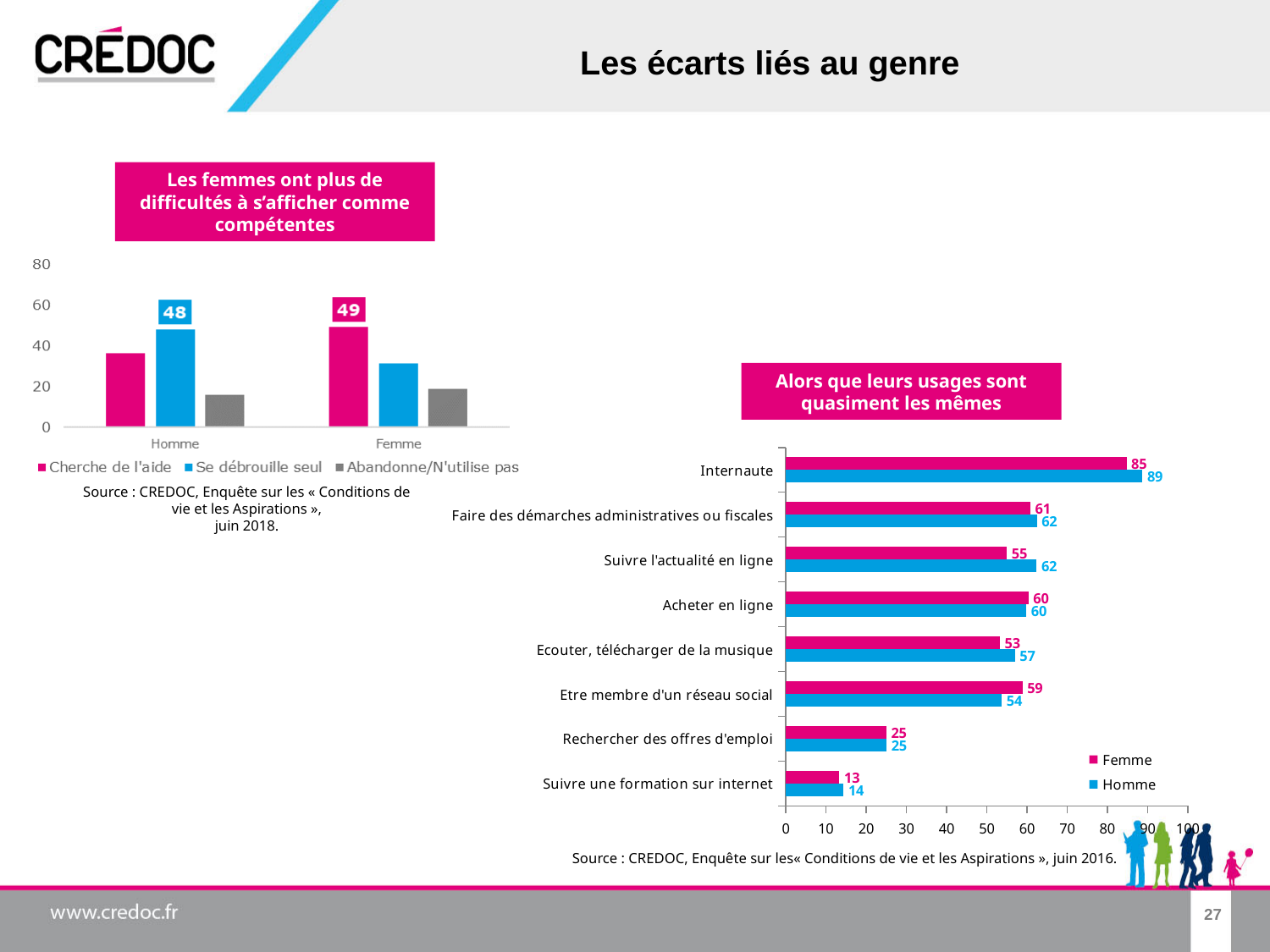
In the right chart, which is larger for 'Ecouter, télécharger de la musique': Femme or Homme? Homme In the right chart, which category has the lowest value for Femme? Suivre une formation sur internet How many series does the legend of the left chart list? 3 In the right chart, which category has the highest value for Homme? Internaute In the left chart, is the value for 'Cherche de l'aide' for Homme greater or less than 40? less In the left chart, what is the value for 'Se débrouille seul' for Homme? 48 In the right chart, what is the value for Femme for 'Etre membre d'un réseau social'? 59 In the left chart, what is the value for 'Cherche de l'aide' for Femme? 49 In the left chart, is the value for 'Abandonne/N'utilise pas' for Homme greater or less than 20? less How many categories are shown in the right chart? 8 In the right chart, what is the difference between Homme and Femme for 'Suivre l'actualité en ligne'? 7 In the right chart, what is the value for Homme for 'Internaute'? 89